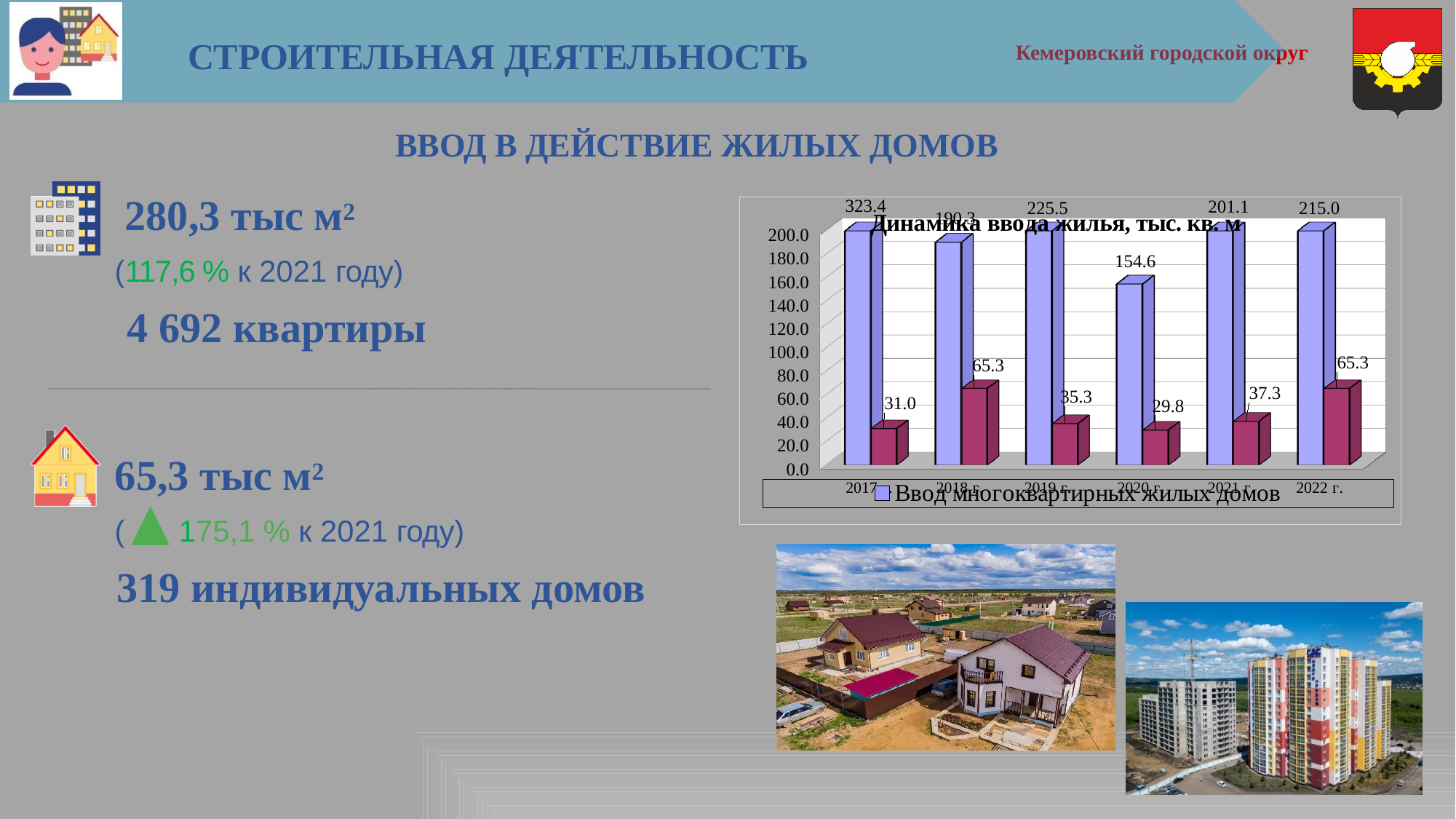
In which year is the red series value the lowest? 2020 г. What is the value for multi-apartment housing in 2019 г.? 225.5 Does the value for multi-apartment housing rise or fall from 2020 г. to 2022 г.? Rise In which year is the value for multi-apartment housing the lowest? 2020 г. What is the value for multi-apartment housing (Ввод многоквартирных жилых домов) in 2017 г.? 323.4 In which year is the value for multi-apartment housing the highest? 2017 г. What kind of chart is shown on the slide? Bar chart What is the value of the red series in 2020 г.? 29.8 What is the difference between the red series values for 2022 г. and 2021 г.? 28.0 Which year has the larger red series value, 2018 г. or 2019 г.? 2018 г. What is the difference between the multi-apartment housing values for 2022 г. and 2021 г.? 13.9 How many years are shown on the x axis of the chart? 6